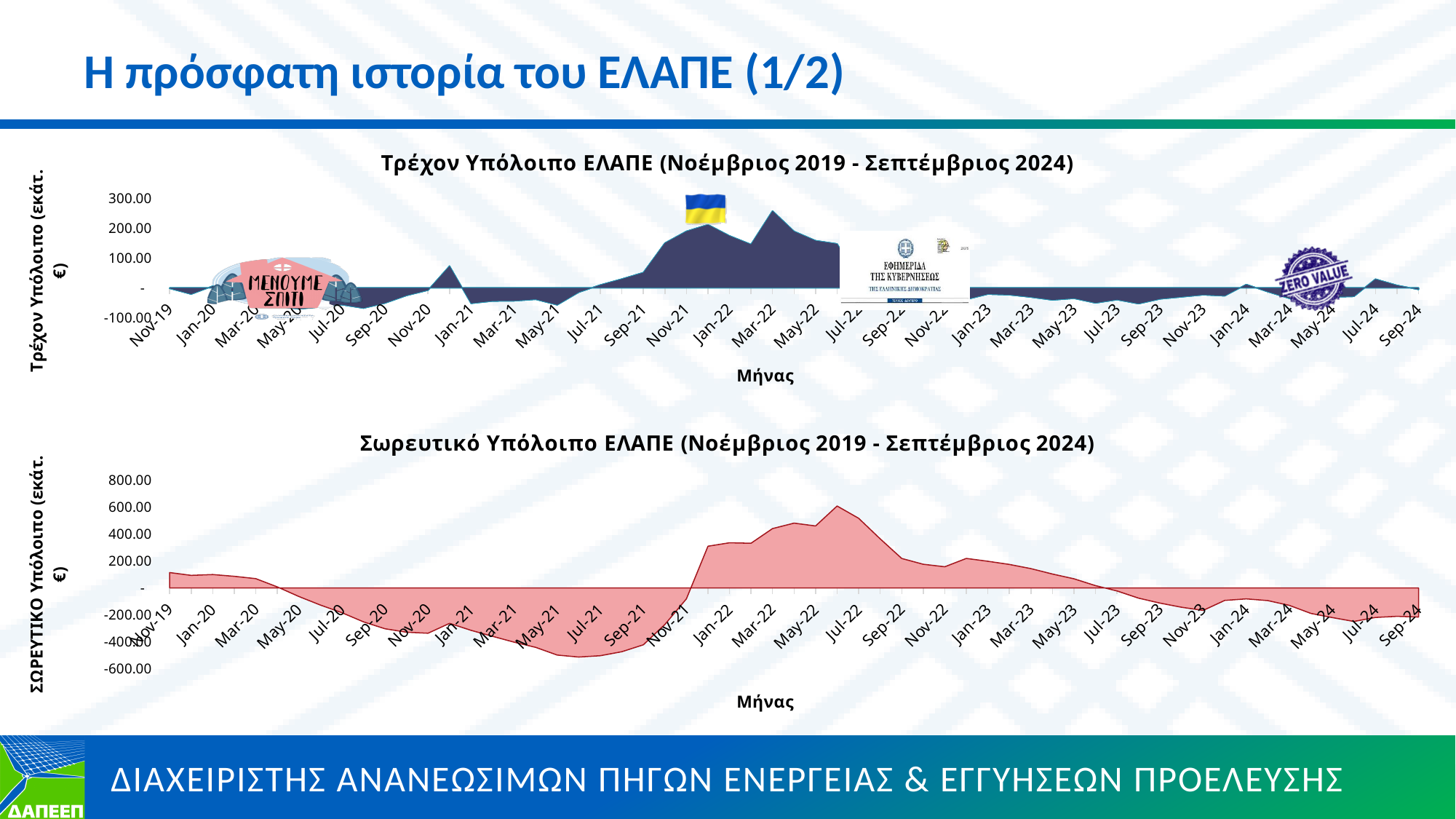
In the top chart (Τρέχον Υπόλοιπο ΕΛΑΠΕ), is the value for Jan-21 greater or less than 100.00? less What kind of chart is the top chart, 'Τρέχον Υπόλοιπο ΕΛΑΠΕ (Νοέμβριος 2019 - Σεπτέμβριος 2024)'? Area chart In the bottom chart (Σωρευτικό Υπόλοιπο ΕΛΑΠΕ), which month has the highest value? Jun-22 In the top chart (Τρέχον Υπόλοιπο ΕΛΑΠΕ), is the value for Mar-22 greater or less than 200.00? greater What is the x-axis title of the top chart (Τρέχον Υπόλοιπο ΕΛΑΠΕ)? Μήνας In the bottom chart (Σωρευτικό Υπόλοιπο ΕΛΑΠΕ), do the values rise or fall from Nov-21 to Jul-22? rise In the bottom chart (Σωρευτικό Υπόλοιπο ΕΛΑΠΕ), is the value for Jul-22 greater or less than 400.00? greater In the top chart (Τρέχον Υπόλοιπο ΕΛΑΠΕ), which month has the highest value? Mar-22 In the top chart (Τρέχον Υπόλοιπο ΕΛΑΠΕ), which is larger, the value for Mar-22 or the value for Jan-21? Mar-22 In the bottom chart (Σωρευτικό Υπόλοιπο ΕΛΑΠΕ), do the values rise or fall from Jan-20 to Jul-21? fall What is the title of the bottom chart on the slide? Σωρευτικό Υπόλοιπο ΕΛΑΠΕ (Νοέμβριος 2019 - Σεπτέμβριος 2024)